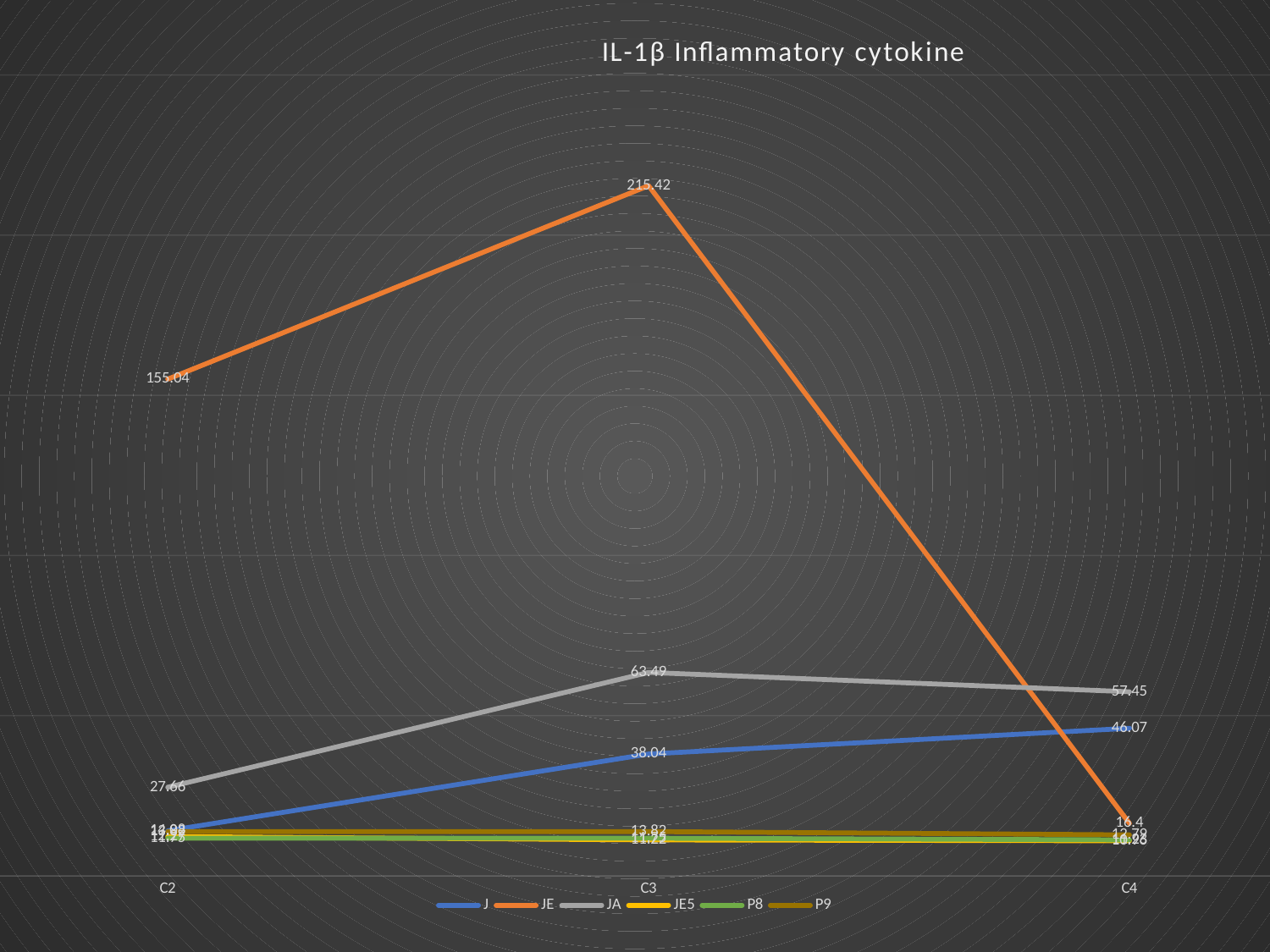
Which is larger at C4, JA or J? JA What type of chart is shown on the slide? line chart At which category is JA lowest? C2 What is the difference between JE at C3 and JE at C2? 60.38 What is the value of JA at C3? 63.49 What is the value of J at C4? 46.07 What is the value of JE at C3? 215.42 How many series does the legend list? 6 At which category does JE reach its highest value? C3 How many categories are shown on the x axis? 3 What is the title of the chart? IL-1β Inflammatory cytokine What is the value of JE at C2? 155.04